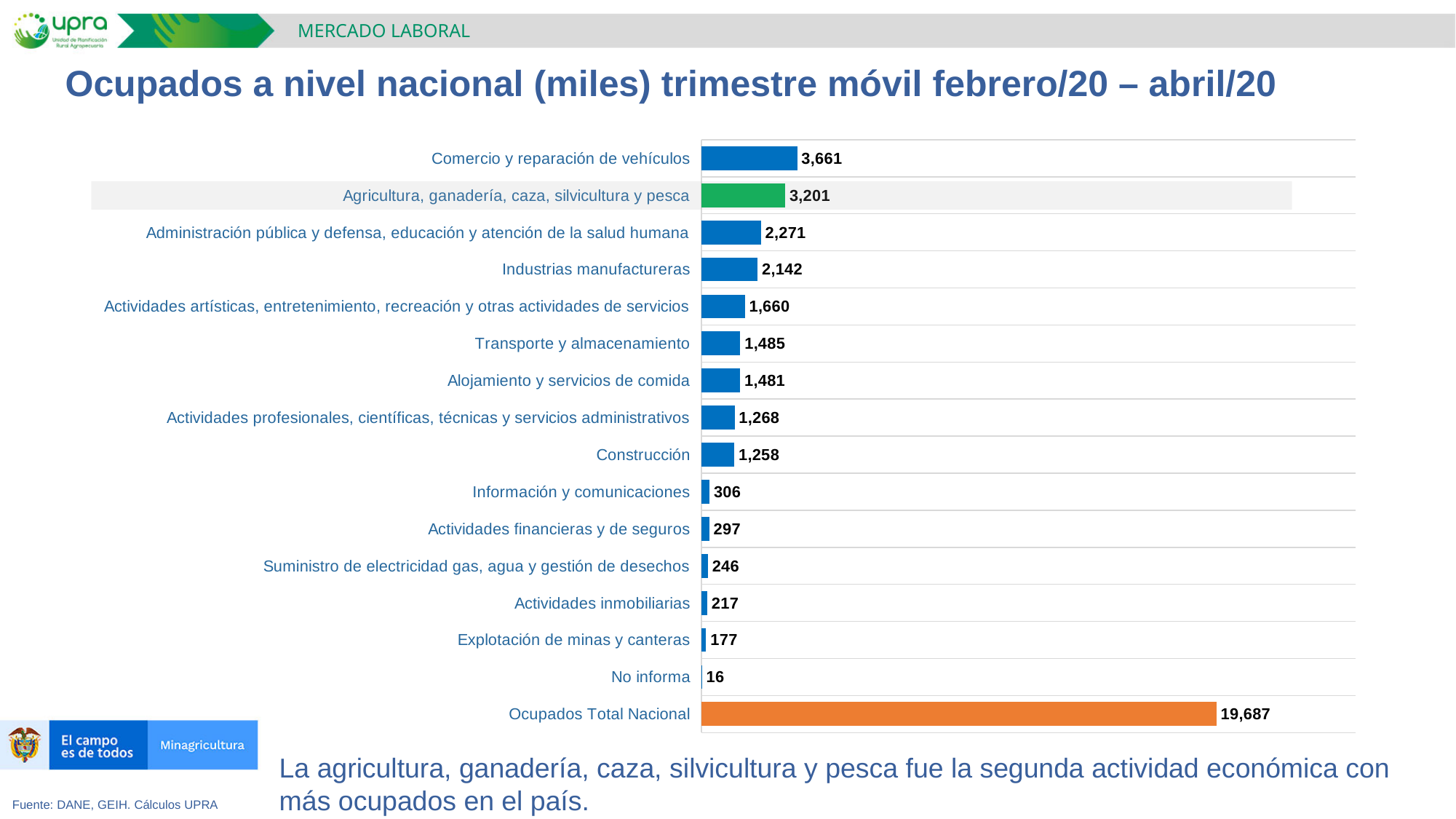
What is the value for Ocupados Total Nacional? 19,687 What is the value for Agricultura, ganadería, caza, silvicultura y pesca? 3,201 What is the difference between Información y comunicaciones and Actividades financieras y de seguros? 9 What colour is the bar for Agricultura, ganadería, caza, silvicultura y pesca? Green How many categories are shown in the chart? 16 Excluding the Ocupados Total Nacional bar, which economic activity has the highest value? Comercio y reparación de vehículos What is the value for Comercio y reparación de vehículos? 3,661 Which category has the lowest value? No informa What is the value for Explotación de minas y canteras? 177 Which is larger, Industrias manufactureras or Construcción? Industrias manufactureras What is the difference between Comercio y reparación de vehículos and Agricultura, ganadería, caza, silvicultura y pesca? 460 What kind of chart is shown on the slide? Bar chart